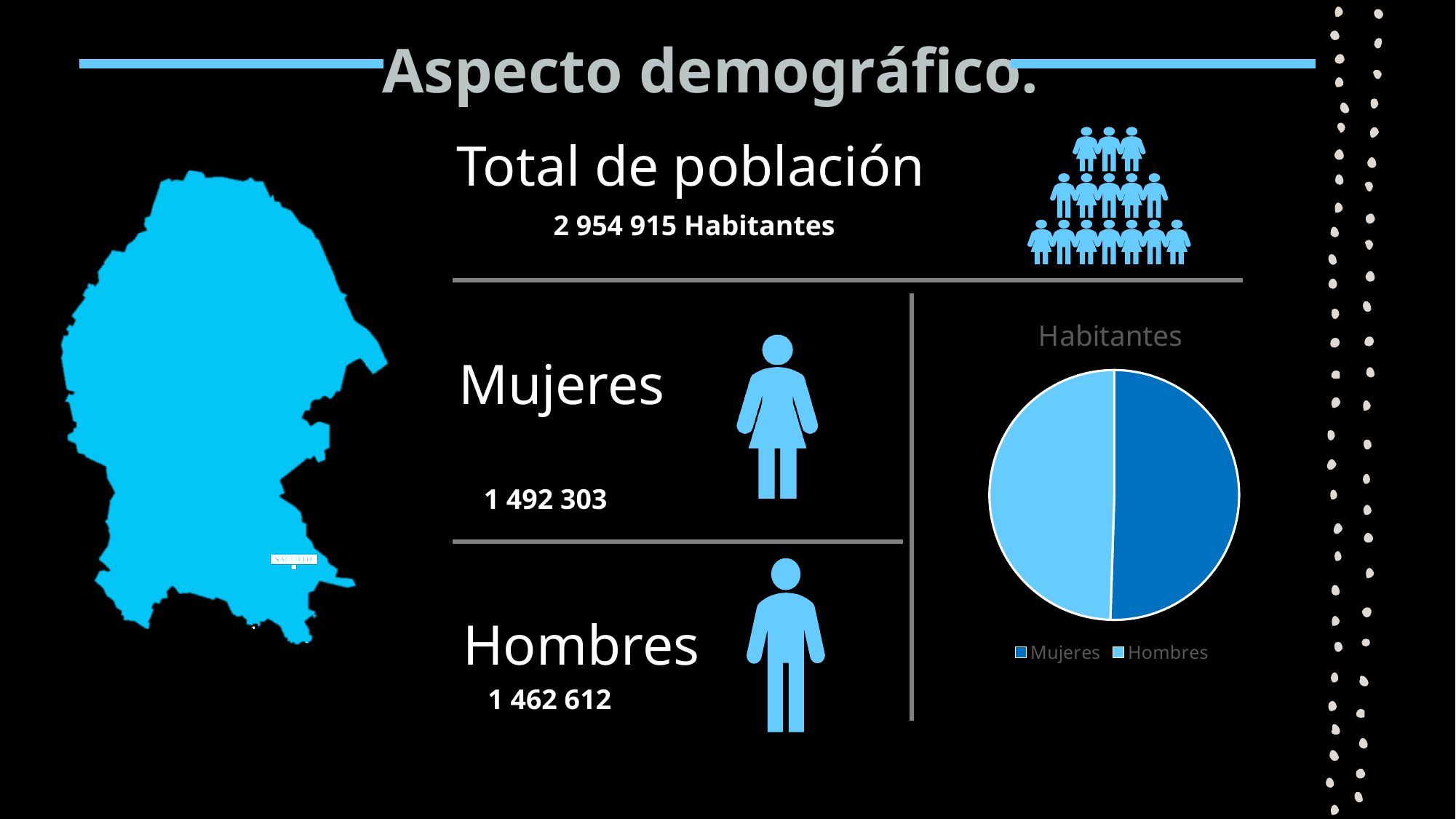
What is the total of the two slices in the "Habitantes" pie chart, as printed on the slide? 2 954 915 Habitantes What is the title of the pie chart on the slide? Habitantes Which slice of the "Habitantes" pie chart is larger, Mujeres or Hombres? Mujeres What kind of chart is shown under the title "Habitantes"? pie chart How many entries does the legend of the "Habitantes" pie chart list? 2 Which two categories are listed in the legend of the "Habitantes" pie chart? Mujeres and Hombres Which category in the "Habitantes" pie chart has the smallest value? Hombres How many slices does the "Habitantes" pie chart have? 2